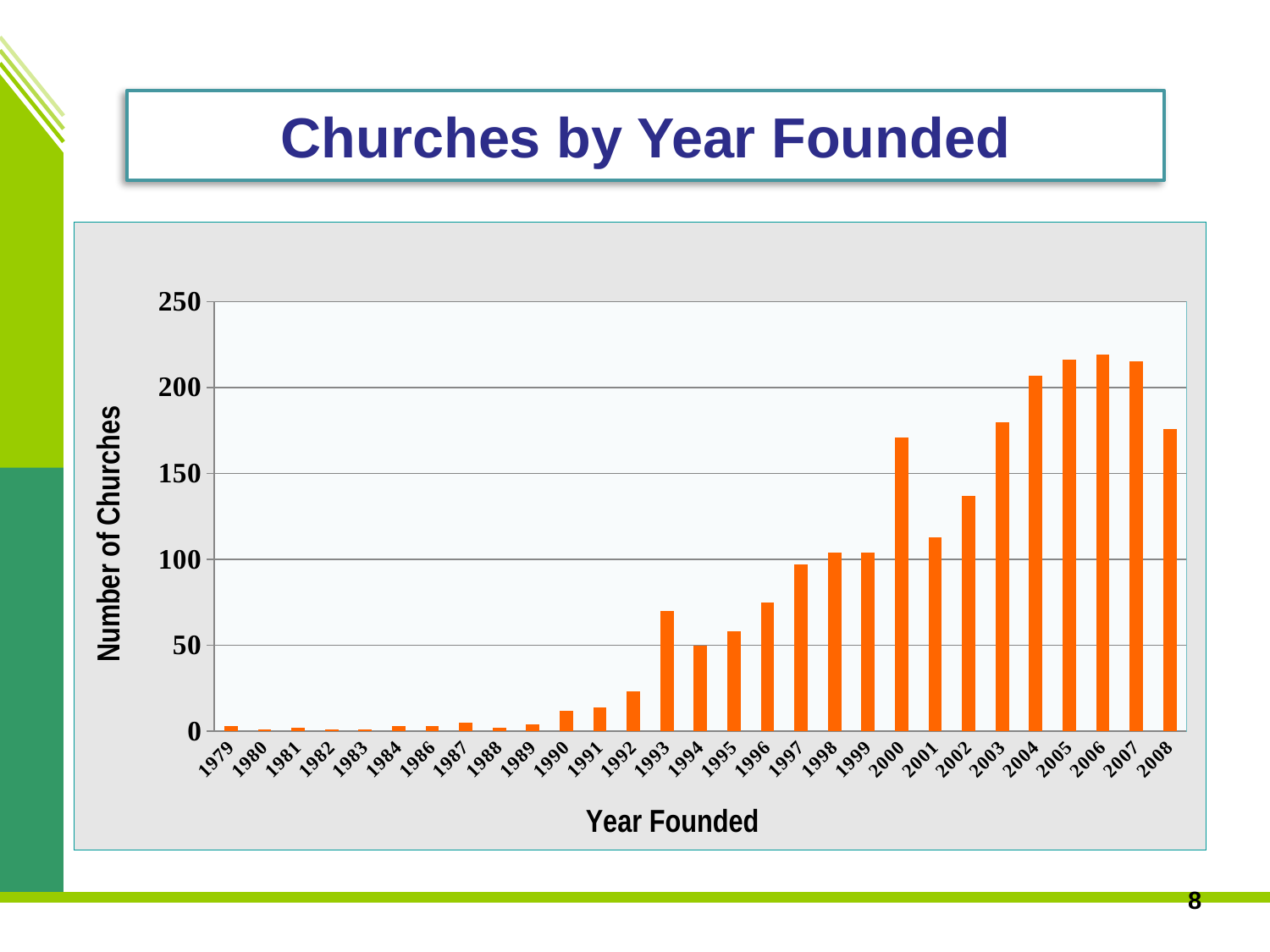
What kind of chart is shown on the slide? Bar chart How many years are shown along the x axis of the chart? 29 Do the values generally rise or fall from 1979 to 2006? rise Is the value for 1996 greater or less than 50? greater Is the value for 2002 greater or less than 150? less Is the value for 1992 greater or less than 50? less What is the title of the vertical axis of the chart? Number of Churches Which year has the larger value, 2000 or 2001? 2000 Which year has the larger value, 1993 or 1994? 1993